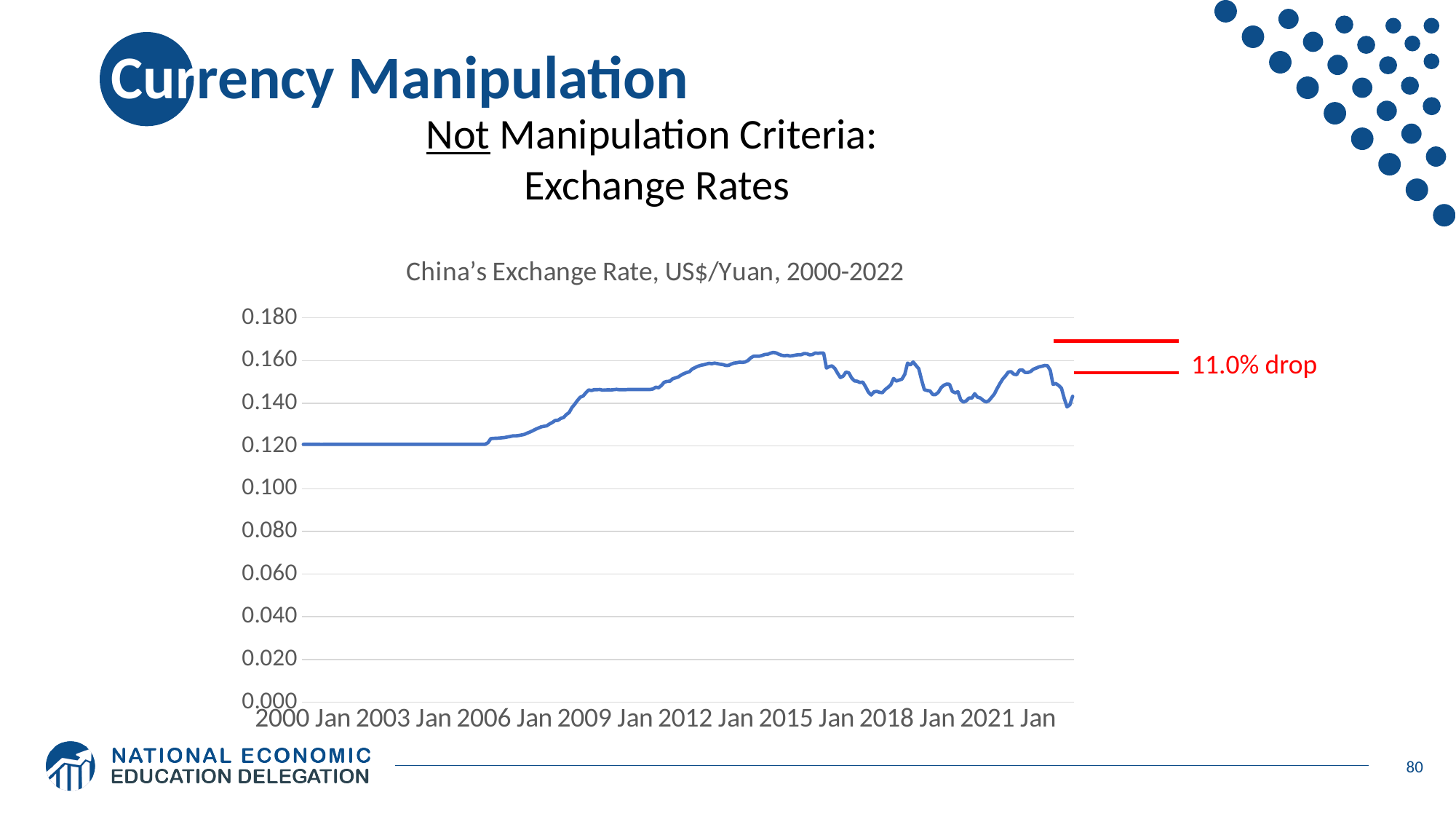
Is the exchange rate value at 2003 Jan greater or less than 0.140? less Is the exchange rate value at 2012 Jan greater or less than 0.140? greater Is the value at 2012 Jan larger or smaller than the value at 2000 Jan? larger What percentage drop is annotated in red on the chart? 11.0% drop Is the highest value reached by the line greater or less than 0.180? less Does the exchange rate rise or fall between 2006 Jan and 2012 Jan? rise Does the exchange rate rise or fall between 2015 Jan and the end of the series? fall What is the highest value shown on the y axis? 0.180 What kind of chart is shown on the slide? line chart How many year labels are shown on the x axis? 8 What is the title of the chart? China's Exchange Rate, US$/Yuan, 2000-2022